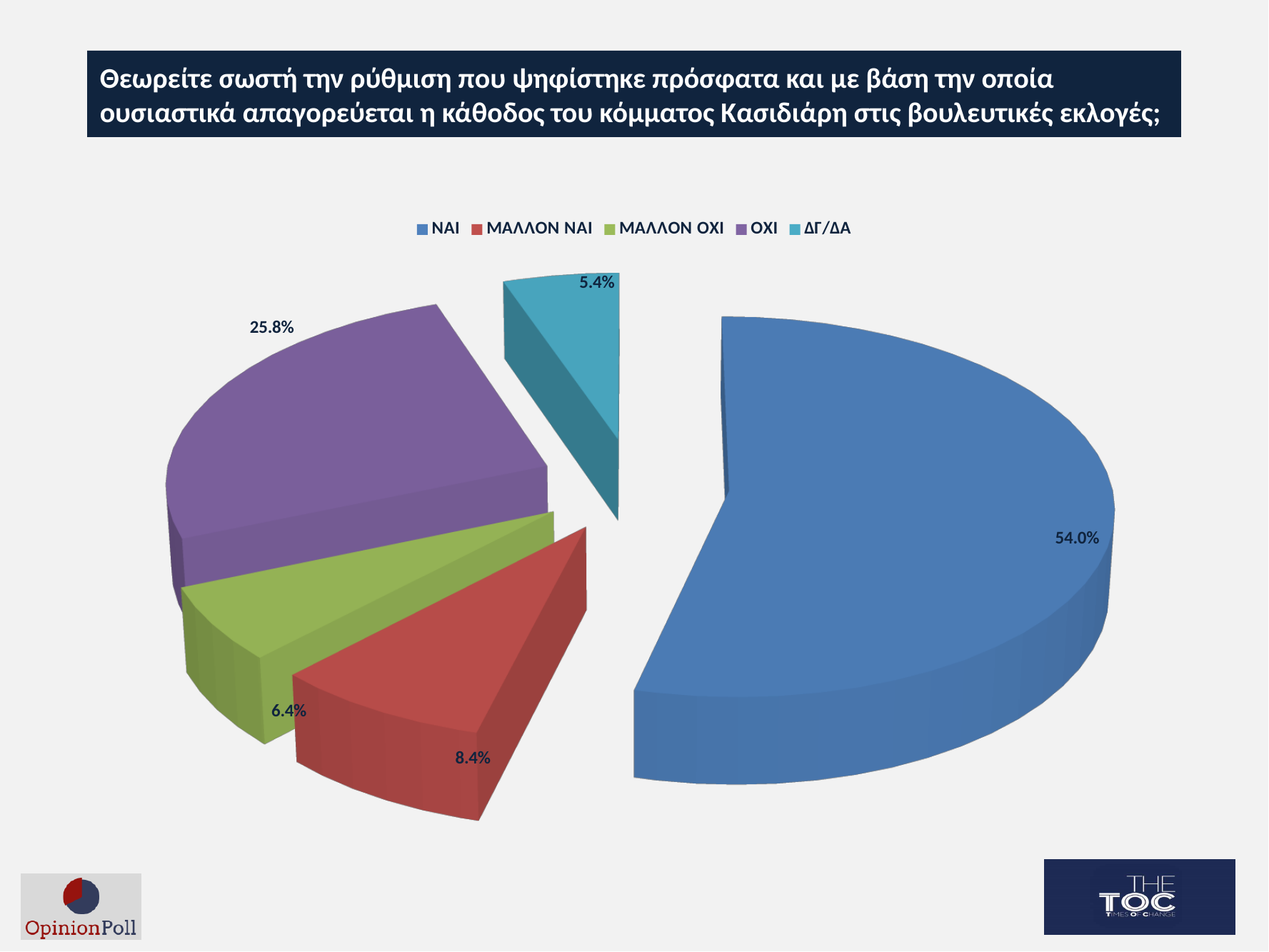
Which category has the largest share of the pie? ΝΑΙ How many slices does the pie chart have? 5 What is the value for ΔΓ/ΔΑ? 5.4% Which is larger, the value for ΜΑΛΛΟΝ ΝΑΙ or the value for ΜΑΛΛΟΝ ΟΧΙ? ΜΑΛΛΟΝ ΝΑΙ What colour is the slice for ΟΧΙ? purple Which category has the smallest share of the pie? ΔΓ/ΔΑ What is the value for ΝΑΙ? 54.0% What is the value for ΜΑΛΛΟΝ ΟΧΙ? 6.4% What is the difference between the values for ΝΑΙ and ΟΧΙ? 28.2% What kind of chart is shown on the slide? pie chart What is the value for ΟΧΙ? 25.8% What is the value for ΜΑΛΛΟΝ ΝΑΙ? 8.4%